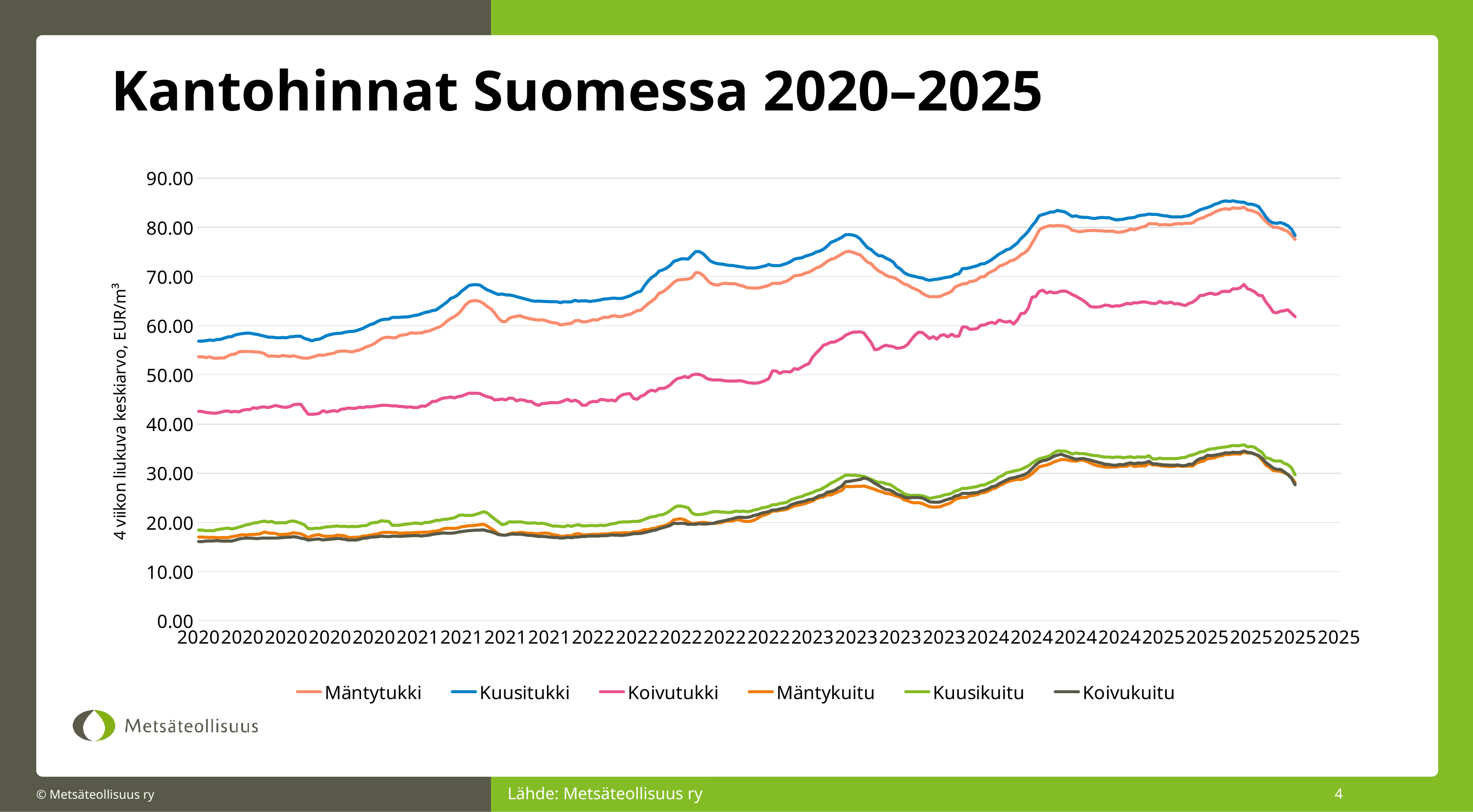
Is the value for Koivutukki at the start of 2020 greater or less than 50? less Does the Koivutukki series overall rise or fall from 2020 to 2025? rise Is the peak value for Kuusitukki in 2025 greater or less than 80? greater What is the label of the vertical axis? 4 viikon liukuva keskiarvo, EUR/m³ Which series has the highest values across the whole period? Kuusitukki Which of the three kuitu series (Mäntykuitu, Kuusikuitu, Koivukuitu) has the highest values? Kuusikuitu Is the value for Mäntykuitu at the end of the period greater or less than 40? less What kind of chart is shown on the slide? line chart Which series is higher throughout the period, Mäntytukki or Koivutukki? Mäntytukki What is the title of the chart? Kantohinnat Suomessa 2020–2025 How many series does the legend list? 6